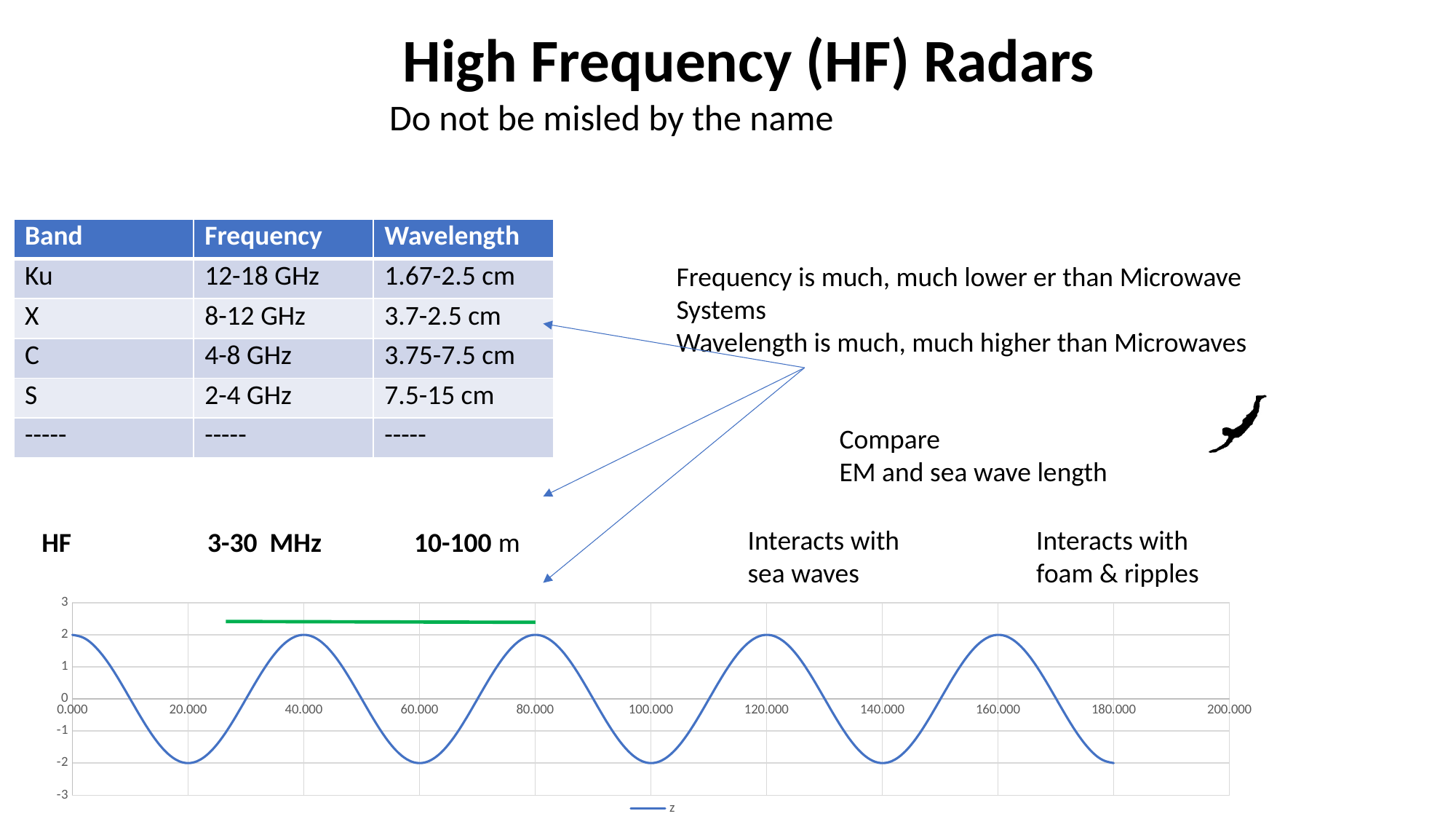
How many series does the chart legend list? 1 Is the value of the line at x = 40.000 greater or less than 1? greater What is the maximum value reached by the line in the chart? 2 Which is larger, the value of the line at x = 80.000 or at x = 60.000? x = 80.000 What is the name of the series shown in the chart legend? z What is the minimum value reached by the line in the chart? -2 What is the value of the line at x = 0.000? 2 Is the value of the line at x = 20.000 greater or less than -1? less What kind of chart is shown at the bottom of the slide? line chart Does the line in the chart rise steadily, fall steadily, or oscillate along the x axis? oscillate What is the value of the line at x = 100.000? -2 How many tick labels are shown on the x axis of the chart? 11